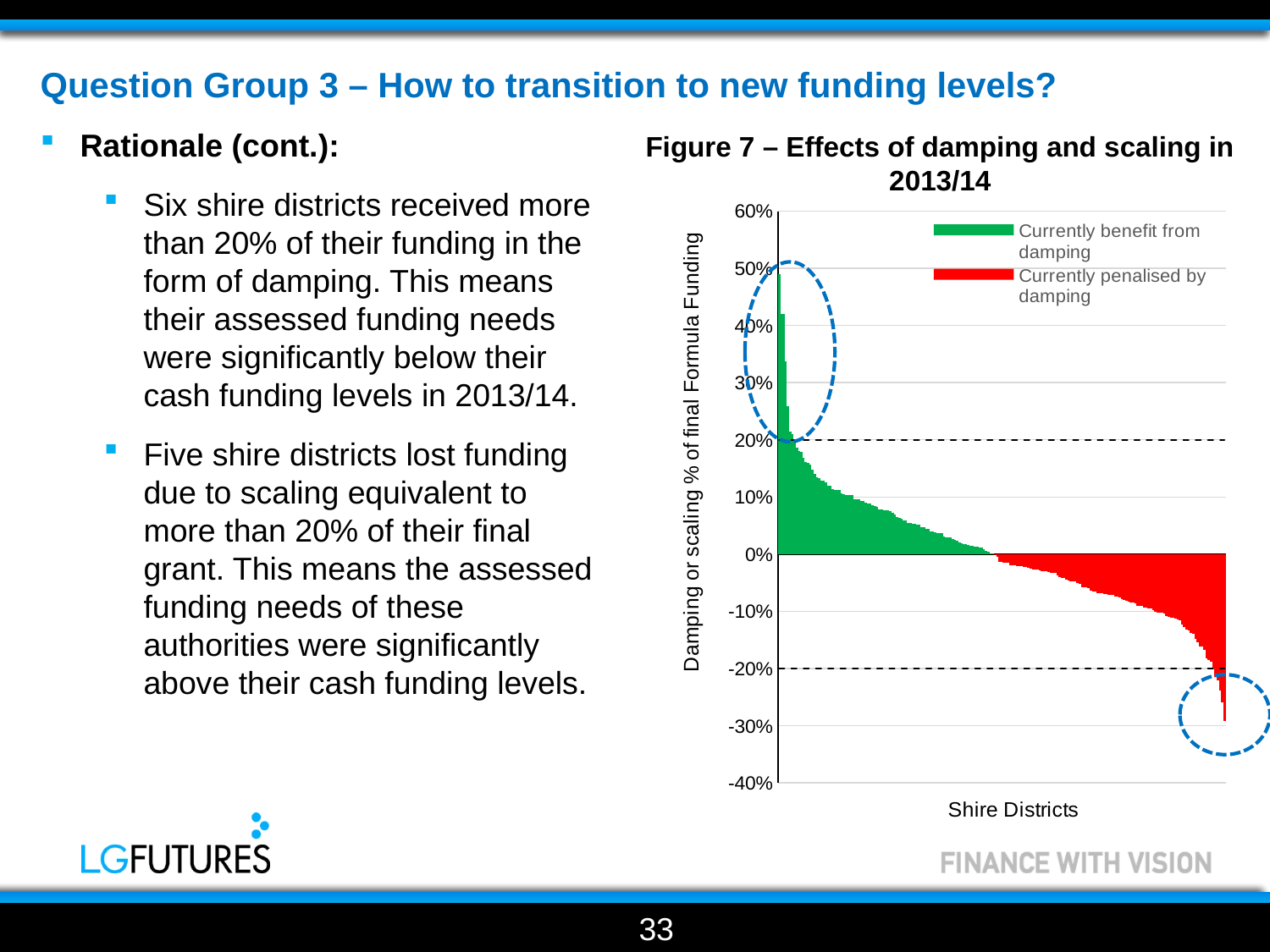
In Figure 7, is the value of the lowest red bar greater or less than -40%? greater What kind of chart is shown in Figure 7? bar chart In Figure 7, which series contains the bar with the largest absolute value: 'Currently benefit from damping' or 'Currently penalised by damping'? Currently benefit from damping In Figure 7, is the value of the lowest red bar greater or less than -20%? less Which legend entry is shown in green in Figure 7? Currently benefit from damping Do the bar values in Figure 7 rise or fall moving from left to right along the x axis? fall What is the title of the chart on the slide? Figure 7 – Effects of damping and scaling in 2013/14 What is the label of the x axis in Figure 7? Shire Districts How many series does the legend of Figure 7 list? 2 In Figure 7, is the value of the tallest green bar greater or less than 40%? greater